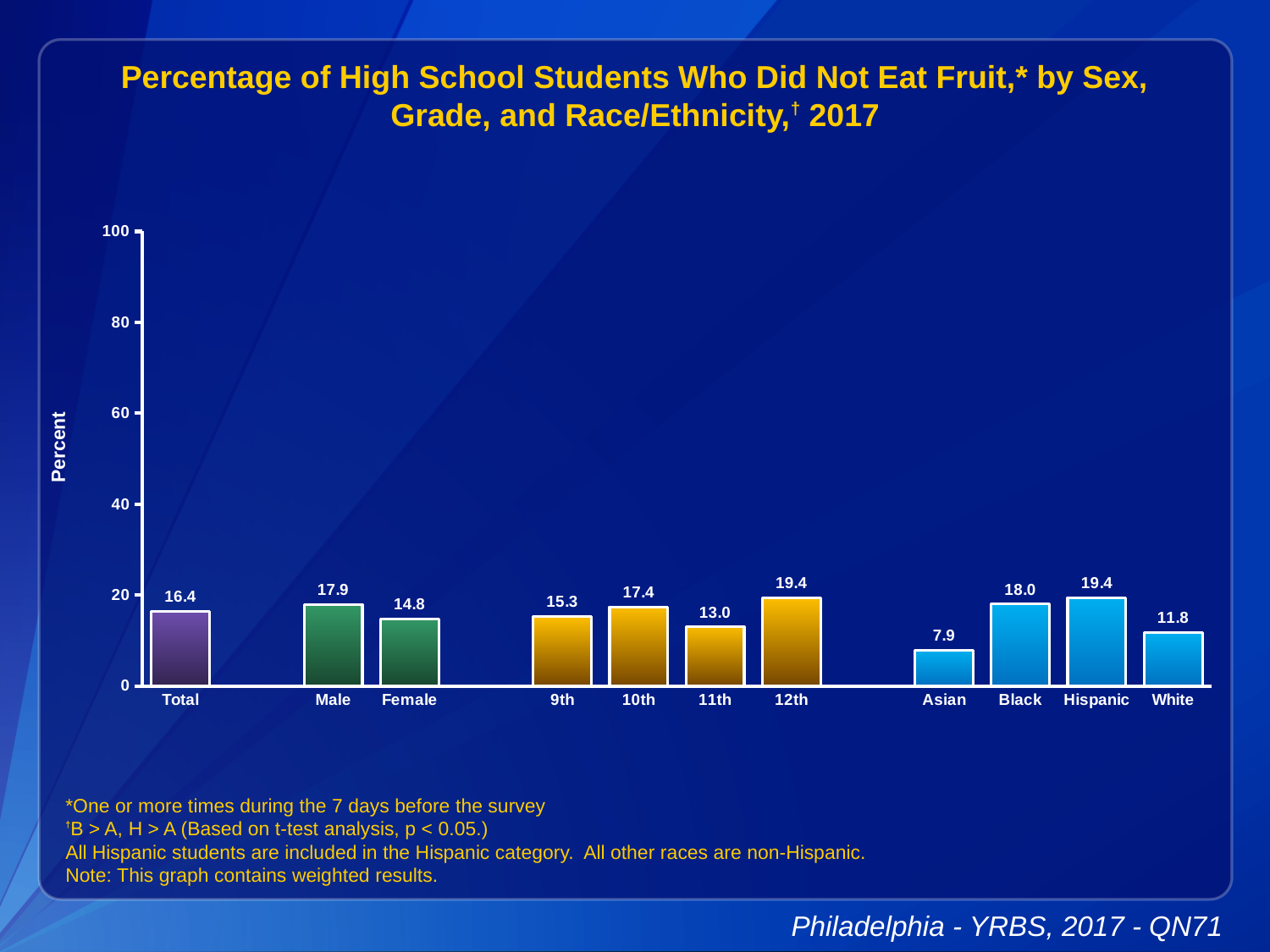
Which grade has the highest value? 12th What is the value for Total? 16.4 How many categories are shown on the x axis? 11 What is the value for 11th grade? 13.0 What is the value for Female? 14.8 What is the difference between the values for 12th grade and 9th grade? 4.1 What kind of chart is this? bar chart What is the difference between the values for Male and Female? 3.1 What is the label of the y axis? Percent Is the value for Hispanic greater or less than 20? less Which is larger, the value for Black or the value for White? Black Which category has the lowest value? Asian